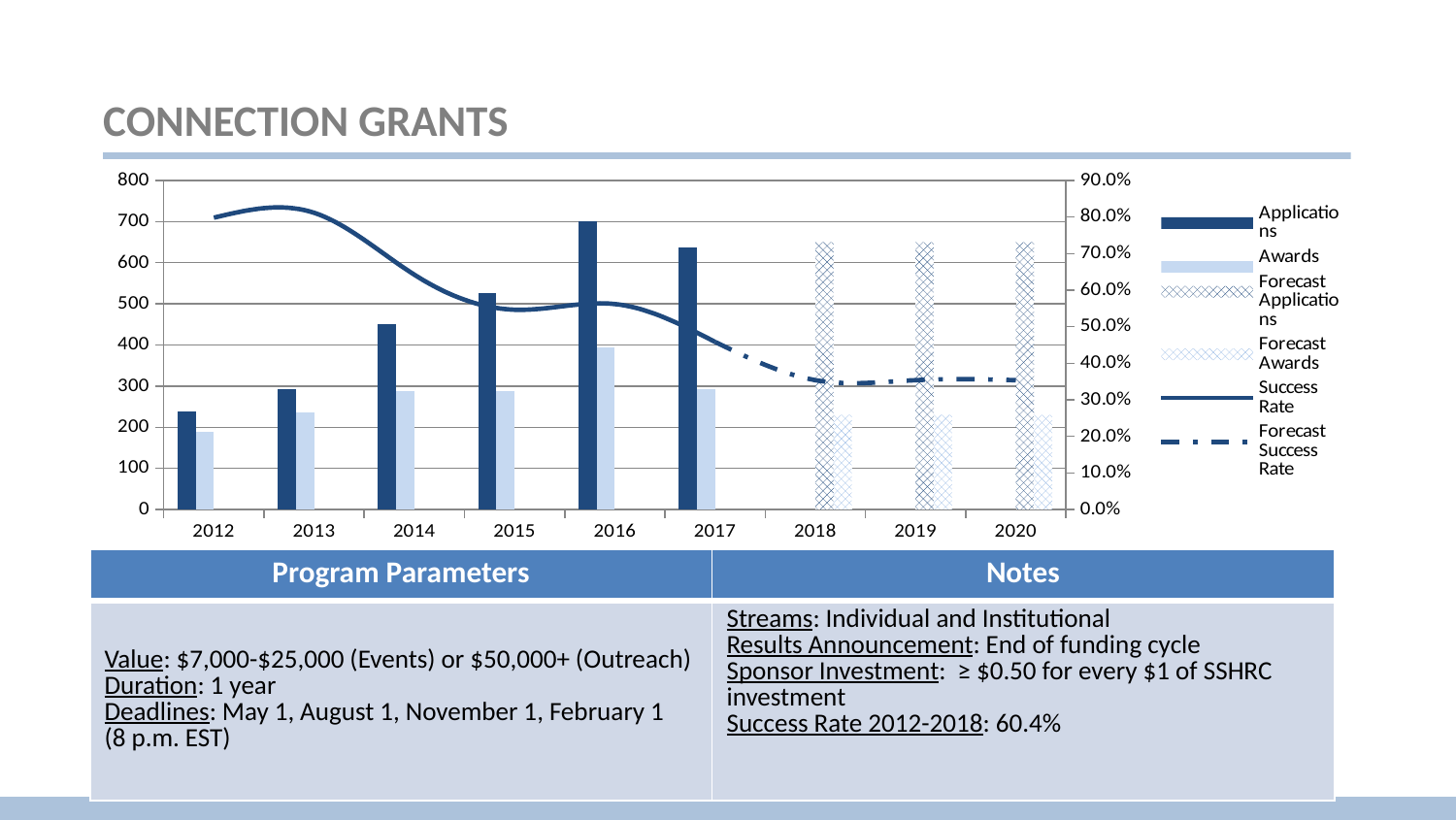
In which year is the Awards bar highest? 2016 What kind of chart is shown on the slide? combination bar and line chart In which year is the Applications bar highest? 2016 Is the Applications value for 2014 greater or less than 400? greater Is the Applications value for 2016 greater or less than 600? greater In which year is the Applications bar lowest? 2012 Is the Awards value for 2016 greater or less than 300? greater Which year has more Applications, 2014 or 2015? 2015 Does the Success Rate line rise or fall from 2012 to 2017? fall How many years are shown along the x axis? 9 How many series does the legend list? 6